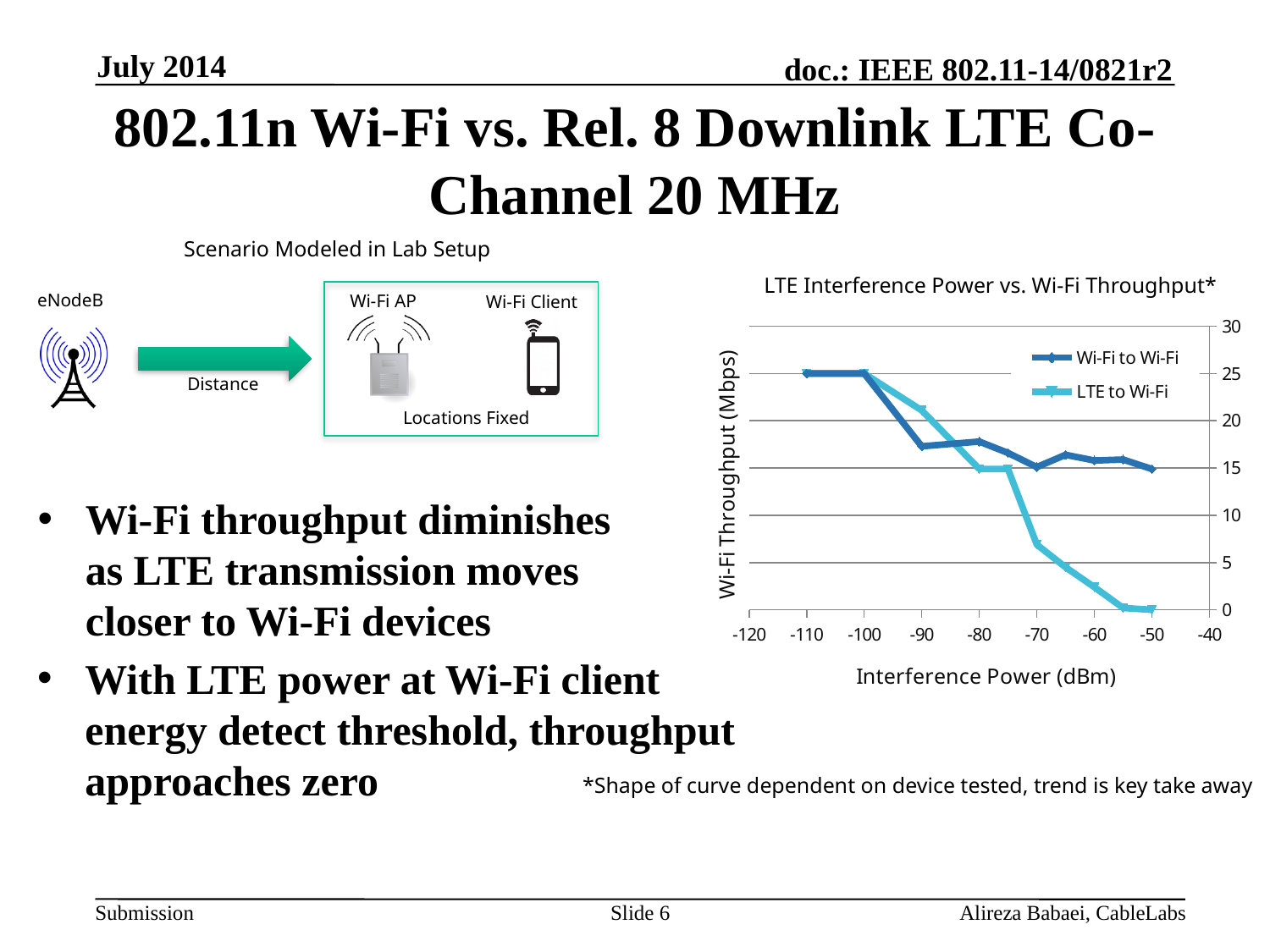
At -70 dBm interference power, which series has the higher Wi-Fi throughput, Wi-Fi to Wi-Fi or LTE to Wi-Fi? Wi-Fi to Wi-Fi How many series does the chart legend list? 2 At -50 dBm interference power, which series has the higher Wi-Fi throughput, Wi-Fi to Wi-Fi or LTE to Wi-Fi? Wi-Fi to Wi-Fi Is the LTE to Wi-Fi throughput at -90 dBm interference power greater or less than 20 Mbps? greater Is the LTE to Wi-Fi throughput at -70 dBm interference power greater or less than 10 Mbps? less Is the LTE to Wi-Fi throughput at -60 dBm interference power greater or less than 5 Mbps? less Does the LTE to Wi-Fi throughput rise or fall as interference power increases from -110 dBm to -50 dBm? fall What are the two series named in the chart legend? Wi-Fi to Wi-Fi and LTE to Wi-Fi What kind of chart is shown on the slide? line chart What is the title of the chart? LTE Interference Power vs. Wi-Fi Throughput*